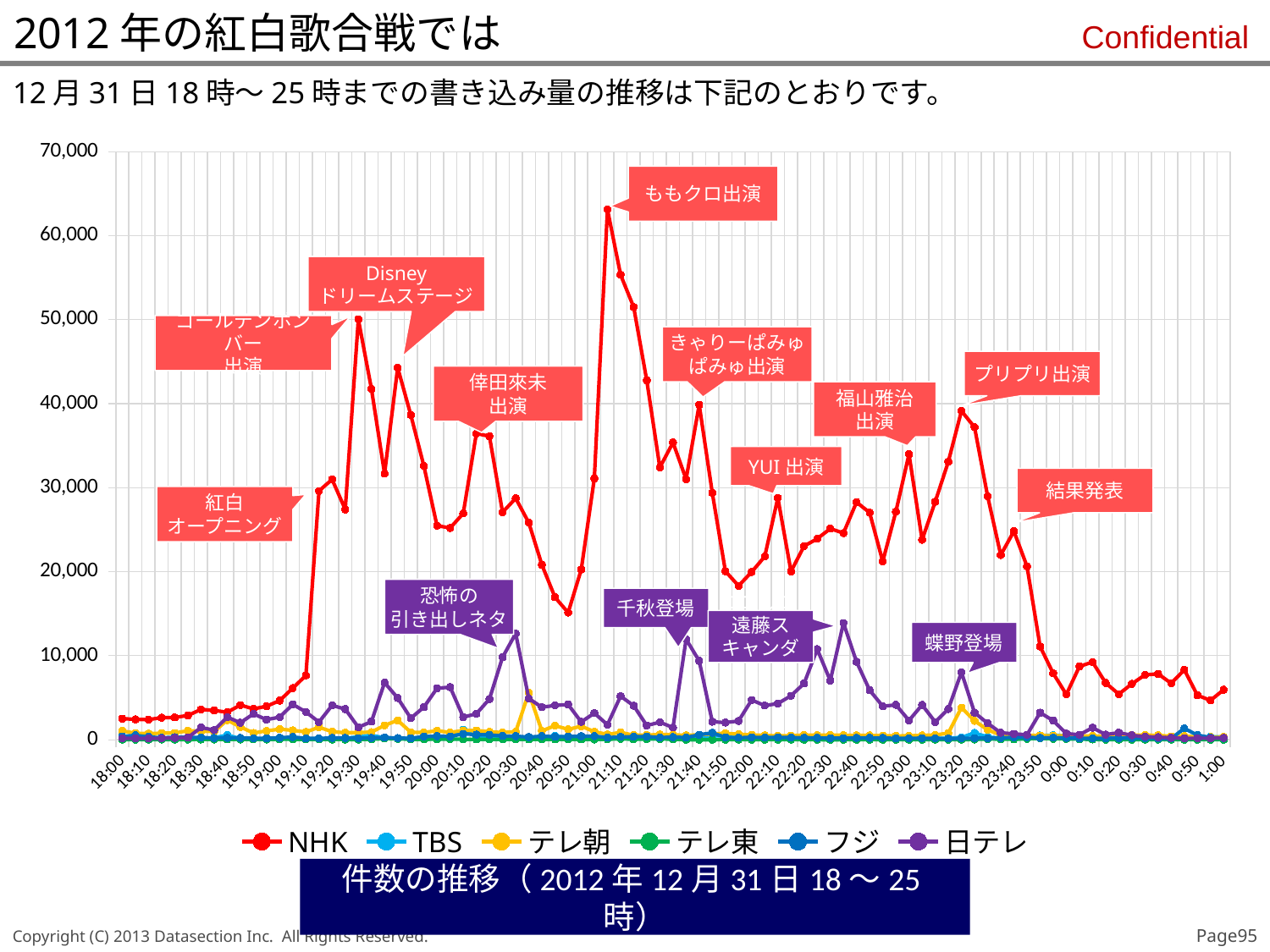
Is the value for NHK at 20:50 greater or less than 20,000? less Which series reaches the highest value on the chart? NHK Is the value for NHK at 21:10 greater or less than 60,000? less What colour is the NHK series drawn in? red How many series does the legend list? 6 Which is larger at 21:10, the value for NHK or the value for 日テレ? NHK What kind of chart is shown on the slide? line chart Does the NHK series rise or fall between 23:20 and 23:50? fall Is the value for NHK at 18:00 greater or less than 10,000? less Which event annotation is attached to the highest peak of the NHK series? ももクロ出演